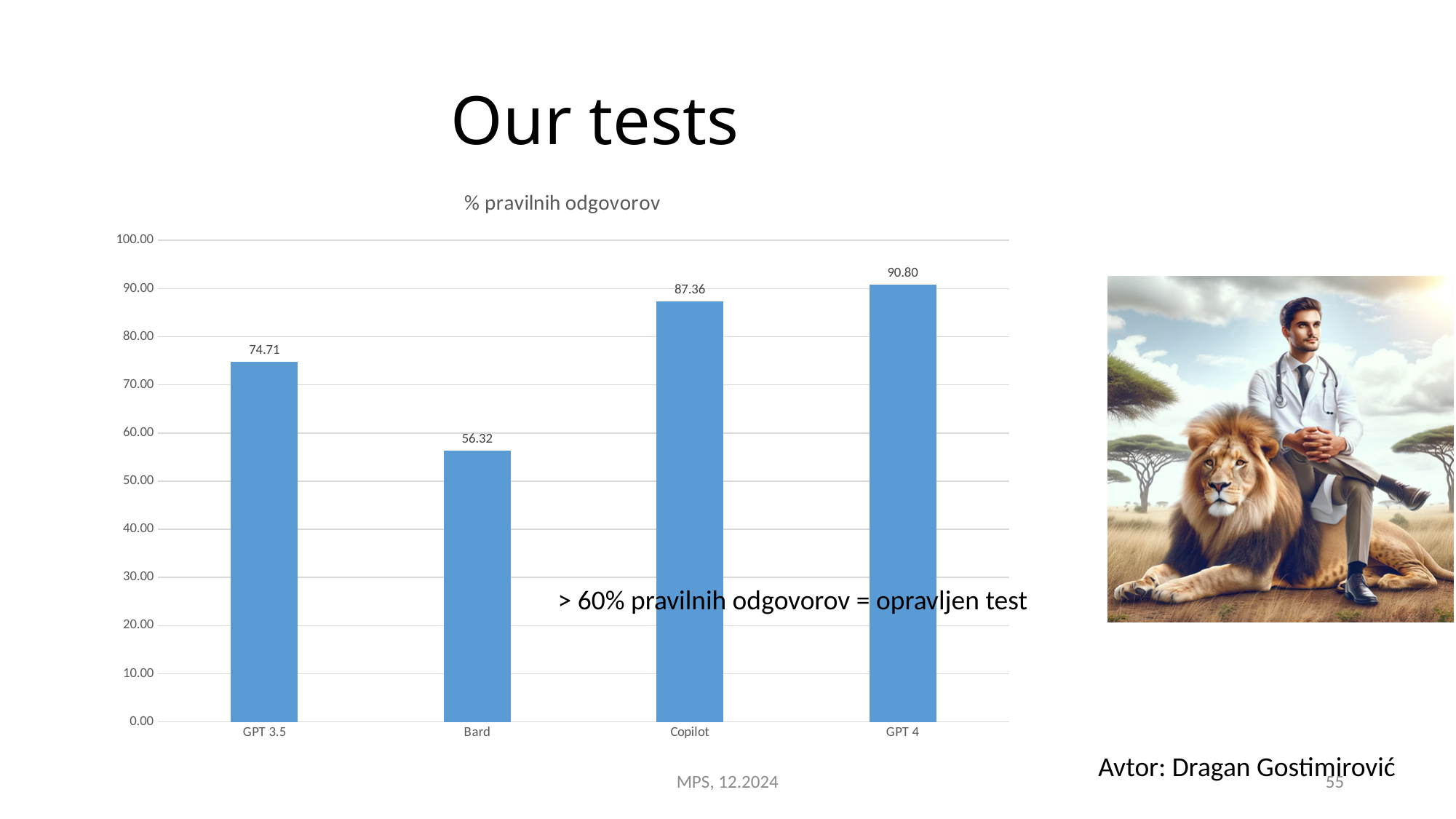
Which is larger, the value for Copilot or the value for Bard? Copilot How many categories are shown in the chart? 4 What is the title of the chart? % pravilnih odgovorov Is the value for Bard greater or less than 60? less What is the value for Bard? 56.32 What is the value for Copilot? 87.36 Which category has the lowest value? Bard Which category has the highest value? GPT 4 What kind of chart is shown on the slide? bar chart What is the value for GPT 3.5? 74.71 What is the value for GPT 4? 90.80 What is the difference between the values for GPT 4 and GPT 3.5? 16.09